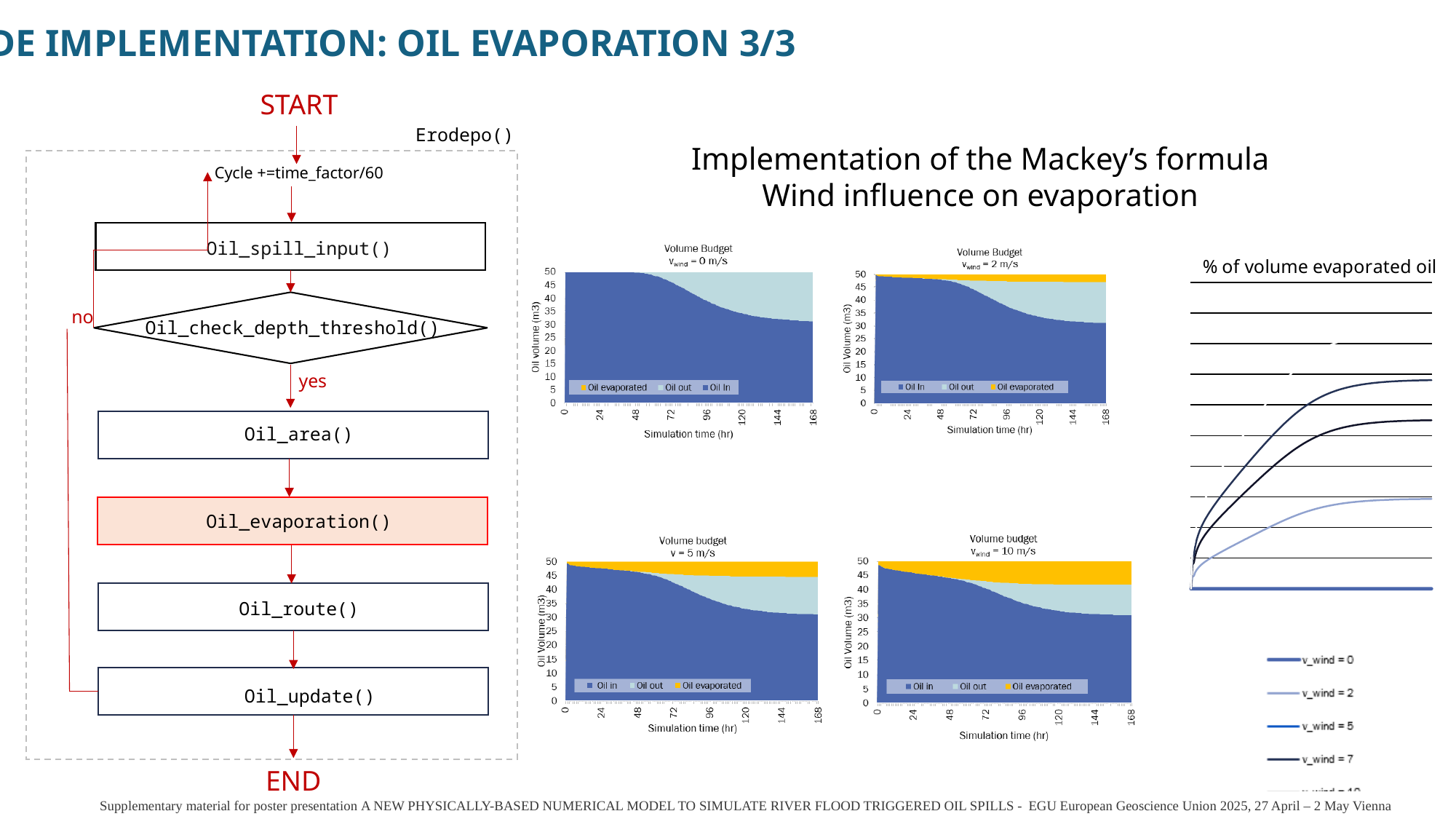
In the 'Volume Budget v_wind = 0 m/s' chart, is the value of Oil In at 168 hr greater or less than 40? less In the 'Volume Budget v_wind = 5 m/s' chart, does the Oil in series rise or fall over the simulation time? fall How many 'Volume Budget' area charts are shown on the slide? 4 In the 'Volume Budget v_wind = 2 m/s' chart, is the value of Oil In at 0 hr greater or less than 40? greater In the '% of volume evaporated oil' line chart, which series stays lowest across the whole x axis? v_wind = 0 In the 'Volume Budget v_wind = 10 m/s' chart, at 168 hr, which is larger: Oil in or Oil evaporated? Oil in What kind of chart is the 'Volume Budget v_wind = 0 m/s' chart? area chart What is the x-axis label of the 'Volume Budget v_wind = 2 m/s' chart? Simulation time (hr) In the 'Volume Budget v_wind = 10 m/s' chart, is the value of Oil in at 24 hr greater or less than 40? greater In the 'Volume Budget v_wind = 0 m/s' chart, what is the total stacked oil volume at 0 hr? 50 What is the title of the line chart on the right of the slide? % of volume evaporated oil How many series does the legend of the 'Volume Budget v_wind = 0 m/s' chart list? 3